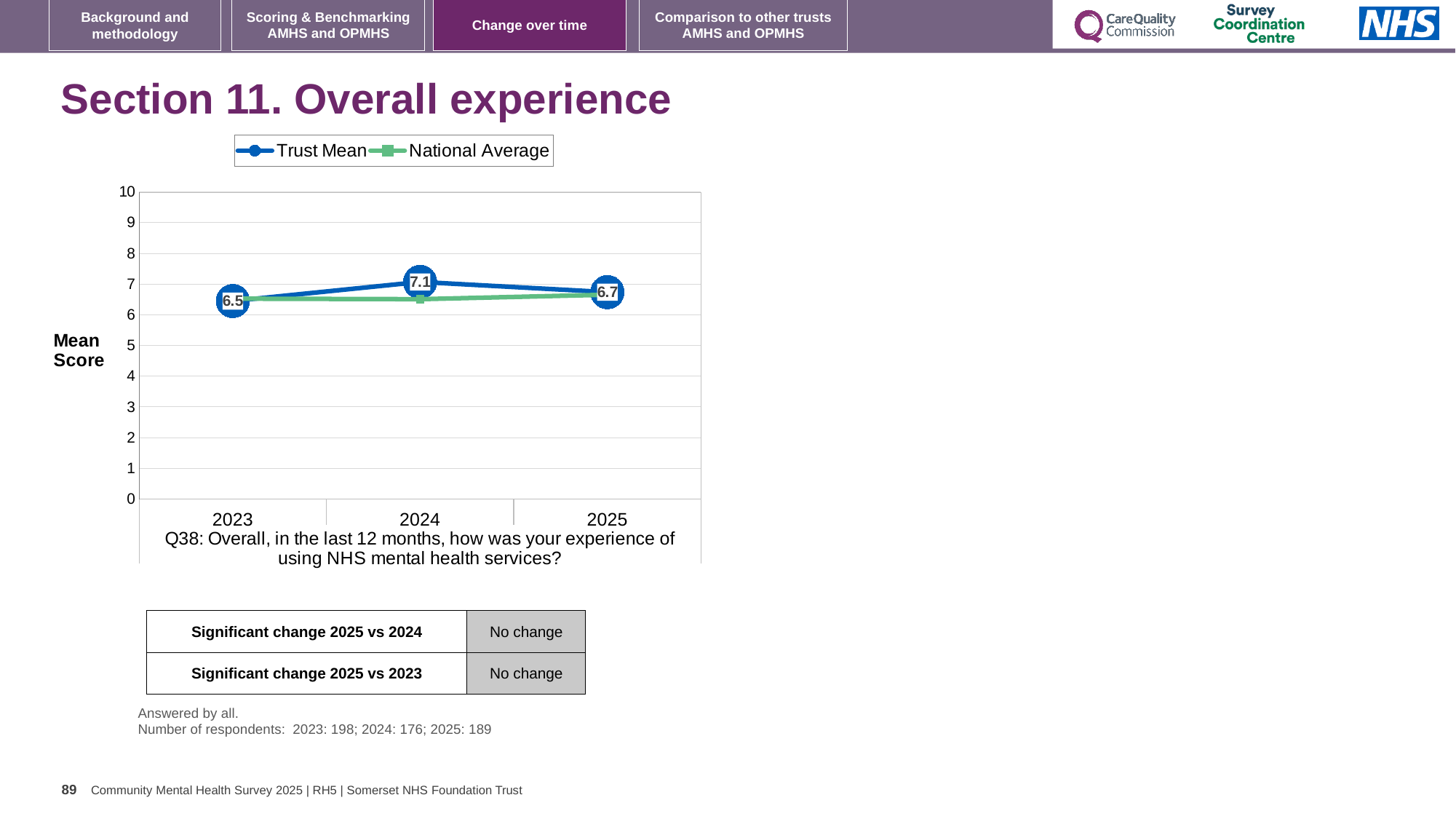
Which is larger, the Trust Mean for 2024 or for 2025? 2024 What is the Trust Mean value for 2023? 6.5 What is the Trust Mean value for 2024? 7.1 Is the National Average value for 2024 greater or less than 7? less How many series does the legend list? 2 What is the label on the y axis of the chart? Mean Score What is the difference between the Trust Mean in 2024 and in 2023? 0.6 In which year is the Trust Mean highest? 2024 What kind of chart is shown on the slide? line chart How many years are plotted on the x axis? 3 What is the Trust Mean value for 2025? 6.7 In which year is the Trust Mean lowest? 2023